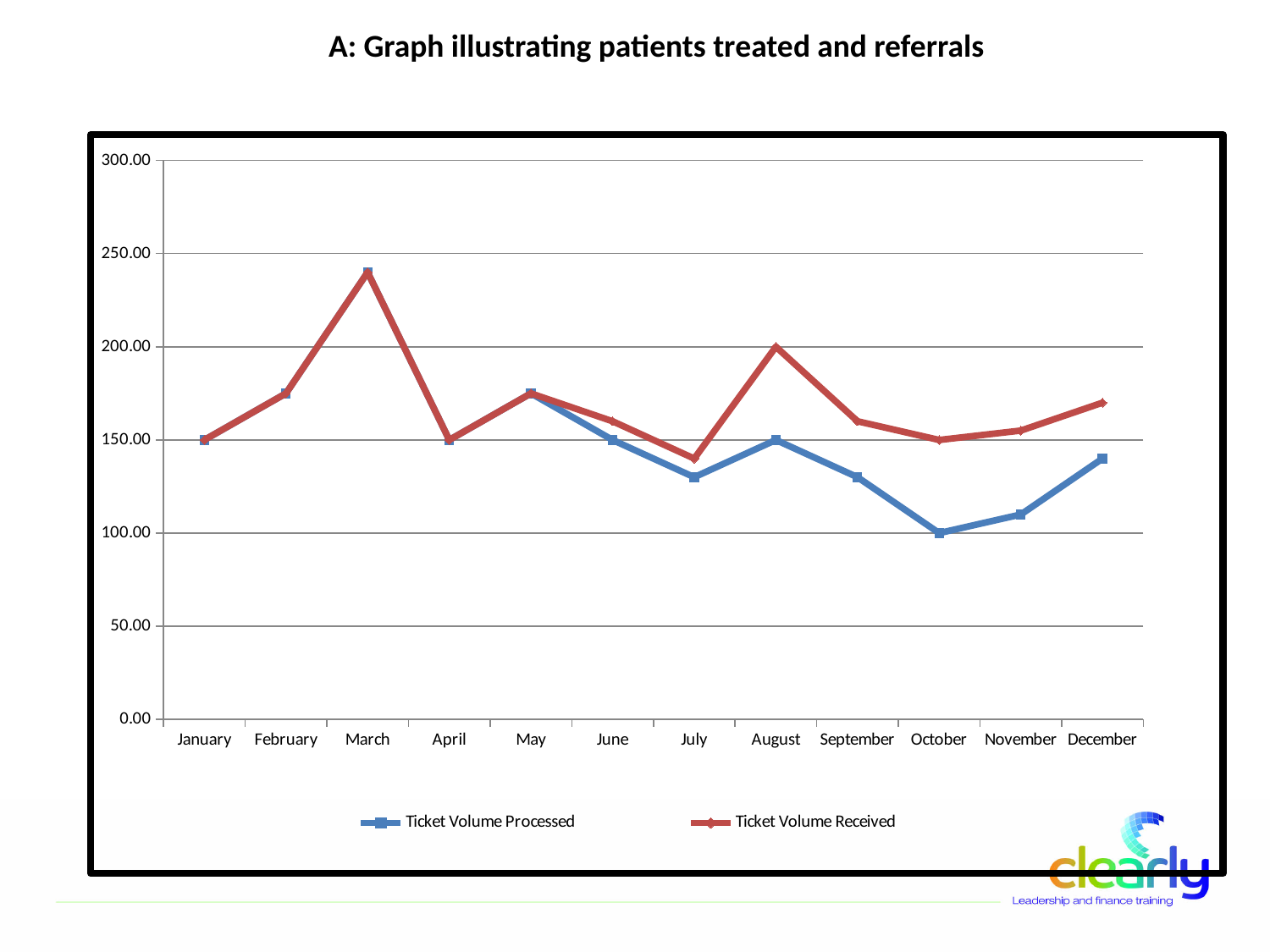
Is the value of Ticket Volume Received in March greater or less than 200? greater In which month is Ticket Volume Processed lowest? October Which is larger: Ticket Volume Received in March or Ticket Volume Received in August? March What is the value of Ticket Volume Received in August? 200.00 What is the value of Ticket Volume Processed in October? 100.00 Is the value of Ticket Volume Processed in July greater or less than 150? less What is the title of the chart? A: Graph illustrating patients treated and referrals Does Ticket Volume Processed rise or fall from August to October? fall How many months are plotted along the x axis? 12 How many series does the legend list? 2 What kind of chart is shown on the slide? line chart In which month is Ticket Volume Received highest? March